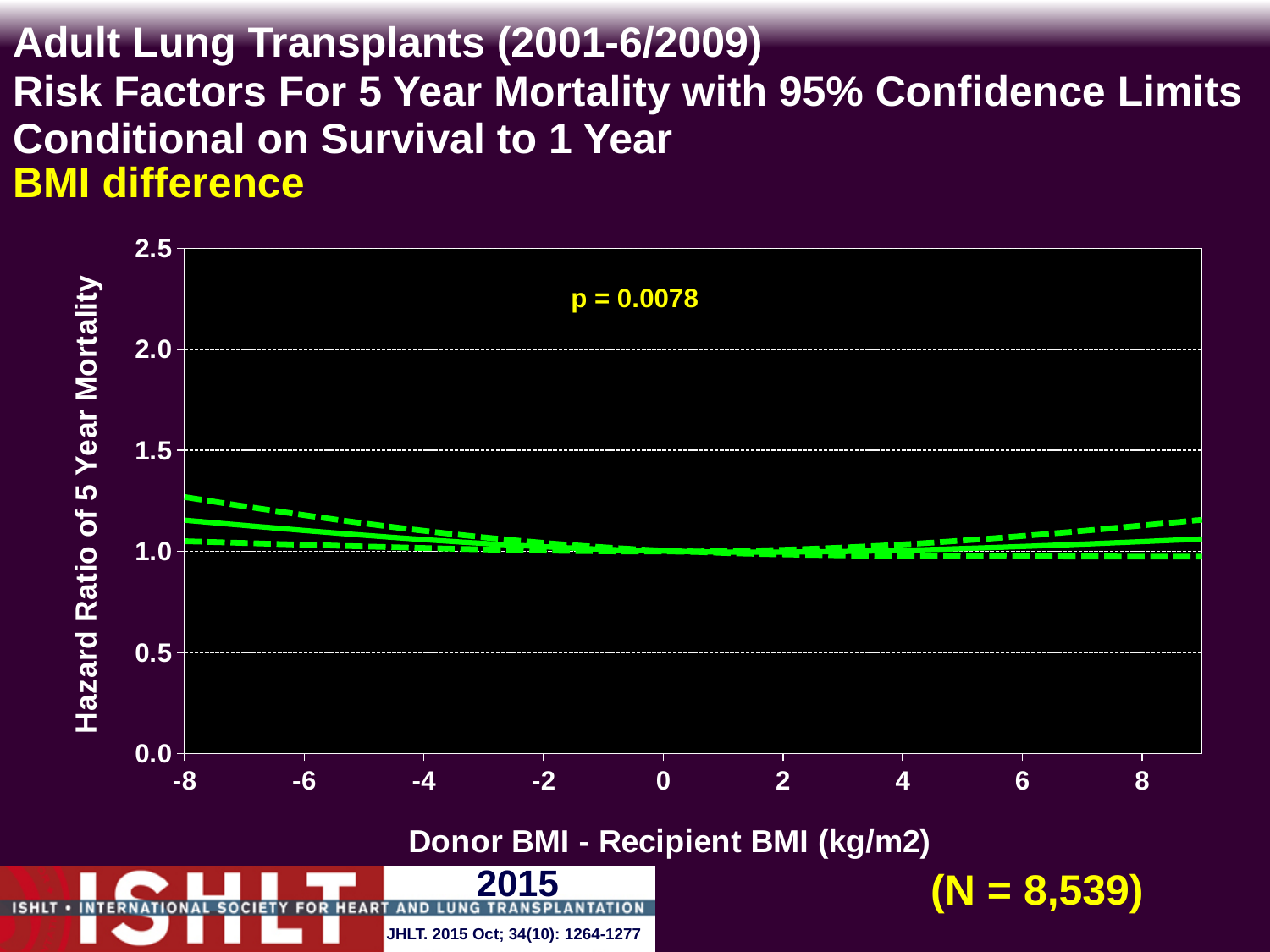
What kind of chart is shown on the slide? line chart Is the upper confidence limit (upper dashed line) at a BMI difference of -8 greater or less than 1.5? less What is the p-value printed on the chart? p = 0.0078 Is the upper confidence limit (upper dashed line) at a BMI difference of 8 greater or less than 1.0? greater Does the hazard ratio (solid line) rise or fall as the BMI difference goes from -8 to 0? falls At which end of the x axis, -8 or 8, does the hazard ratio (solid line) reach its highest value? -8 Is the hazard ratio (solid line) at a BMI difference of 0 greater or less than 1.5? less How many lines (solid and dashed) are plotted on the chart? 3 Is the hazard ratio (solid line) larger at a BMI difference of -8 or at a BMI difference of 0? -8 How many tick labels are shown on the x axis (Donor BMI - Recipient BMI)? 9 What sample size (N) is printed on the slide? N = 8,539